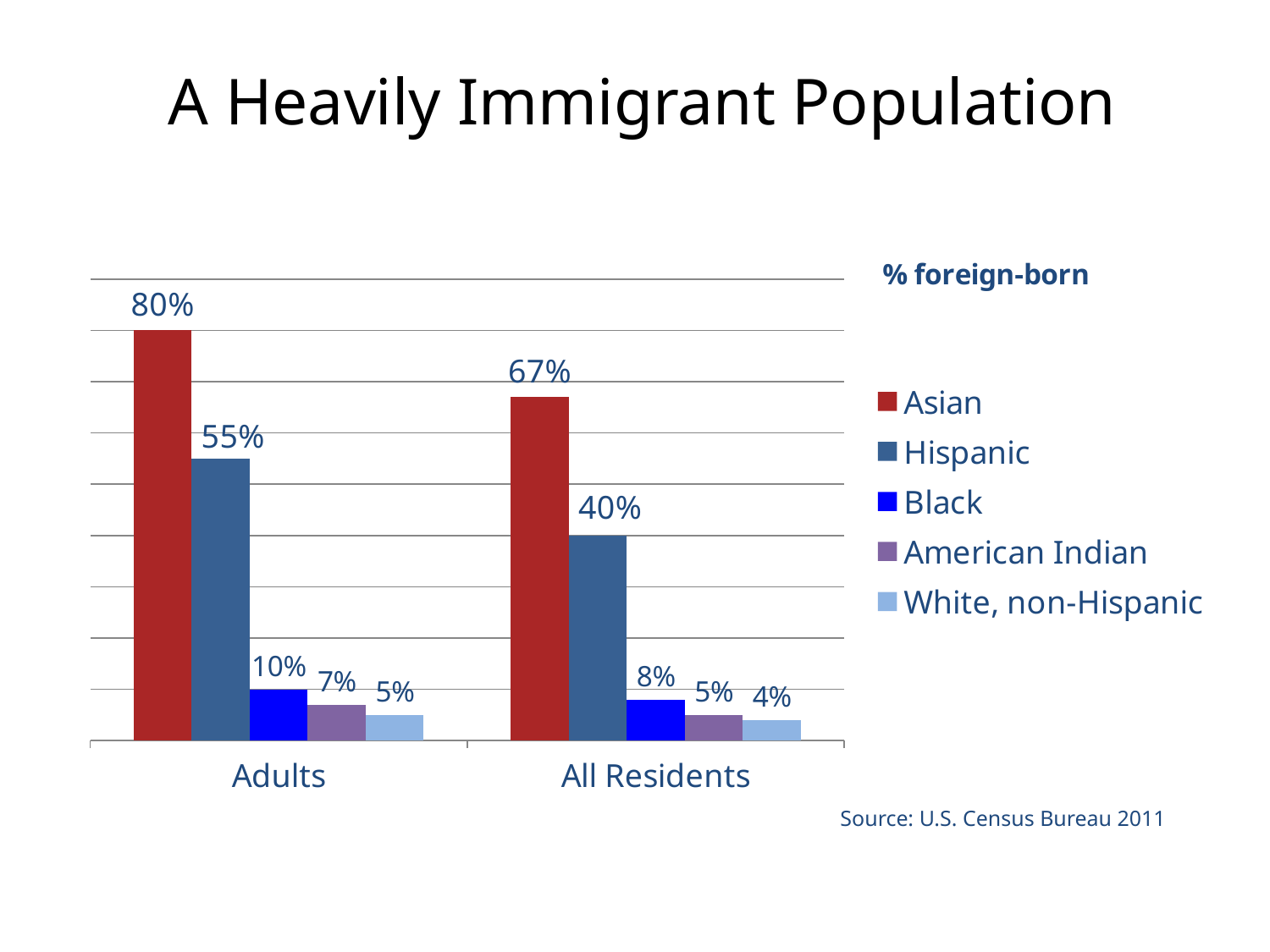
Which group has the lowest % foreign-born among Adults? White, non-Hispanic What kind of chart is shown on the slide? Bar chart What is the % foreign-born for White, non-Hispanic among Adults? 5% What is the difference between the Asian and Hispanic % foreign-born among Adults? 25% Which group has the highest % foreign-born among All Residents? Asian What colour are the bars for the Asian group? Red What is the % foreign-born for Hispanic among All Residents? 40% What is the difference between the Black % foreign-born for Adults and for All Residents? 2% How many categories are shown on the x axis? 2 How many groups does the legend list? 5 What is the % foreign-born for Asian among Adults? 80% Which is larger: the Hispanic % foreign-born for Adults or for All Residents? Adults